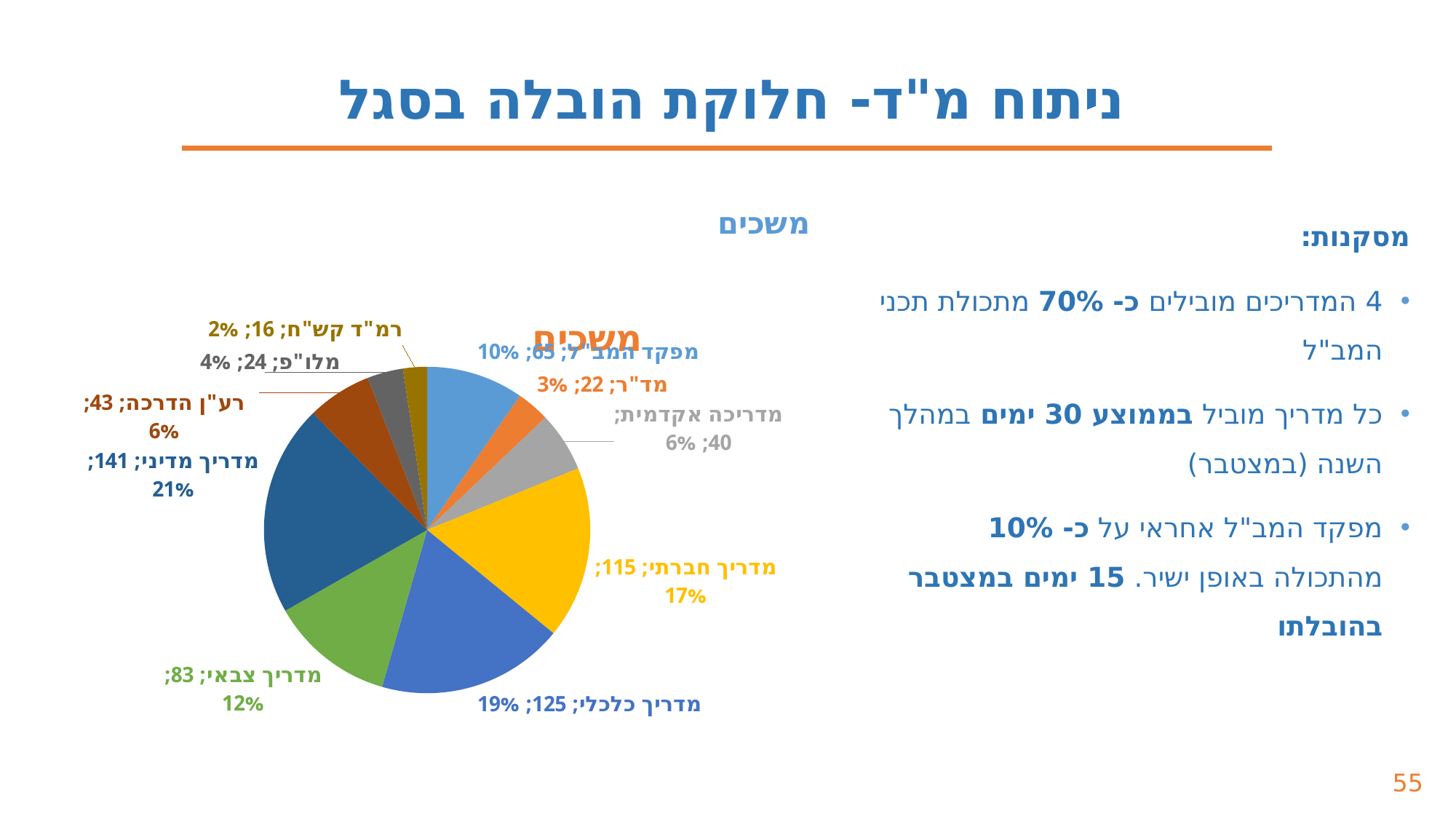
How many slices does the pie chart have? 10 Which category has the smallest slice in the pie chart? רמ"ד קש"ח What is the difference between the values for מדריך כלכלי and מדריך חברתי? 10 What is the value for מפקד המב"ל in the pie chart? 65 What share of the pie does מדריכה אקדמית represent? 6% What is the title of the pie chart? משכים Which category has the largest slice in the pie chart? מדריך מדיני What share of the pie does מדריך כלכלי represent? 19% What kind of chart is shown on the slide? pie chart What is the value for מלו"פ in the pie chart? 24 What is the value for מדריך מדיני in the pie chart? 141 Which is larger, the value for מדריך צבאי or the value for רע"ן הדרכה? מדריך צבאי